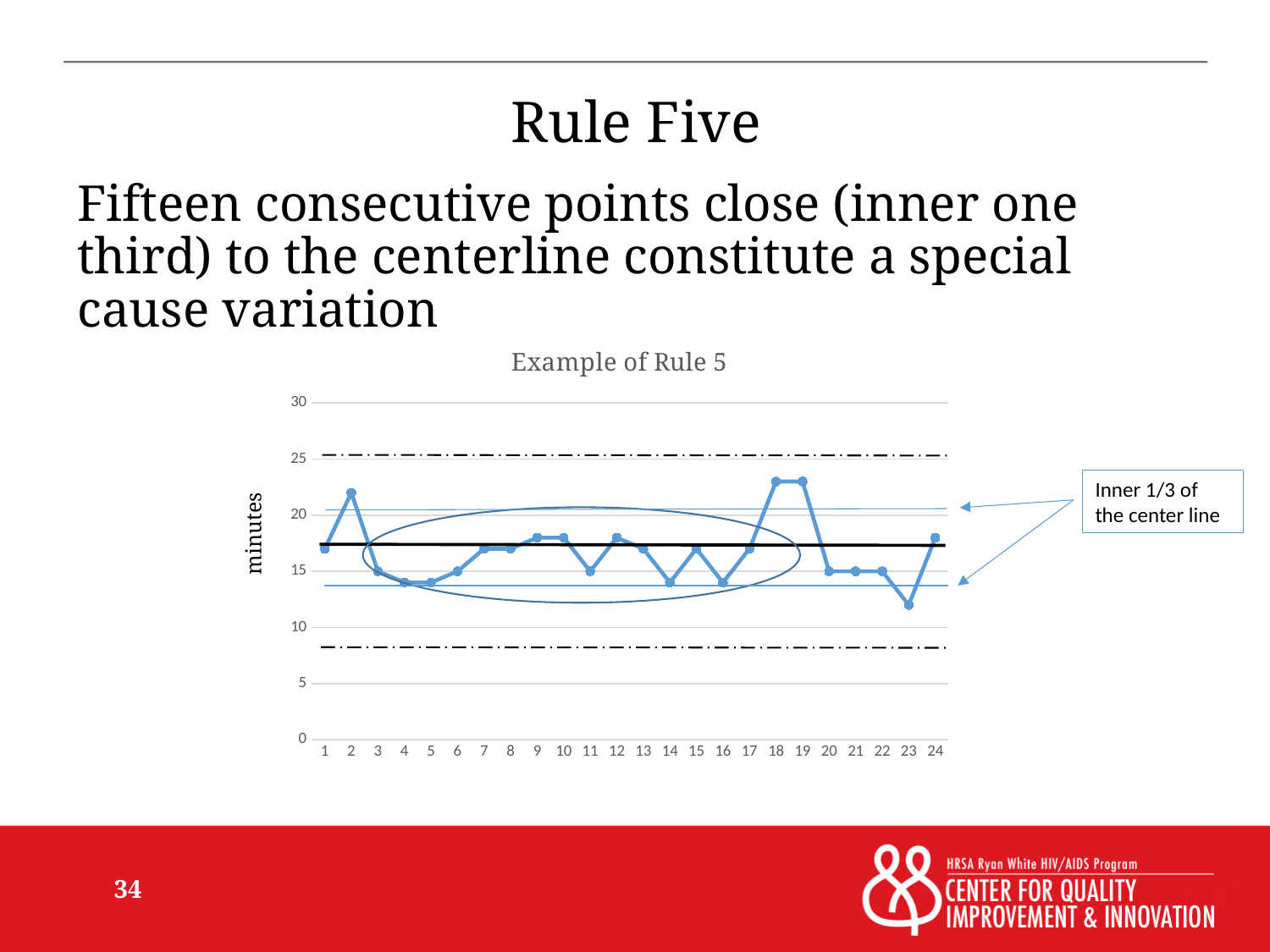
Is the value at point 4 greater or less than 15? less How many data points are plotted on the x axis of the chart? 24 Is the value at point 23 greater or less than 15? less Is the value at point 3 greater or less than 10? greater What kind of chart is shown on the slide? line chart What is the title of the chart? Example of Rule 5 Which is larger, the value at point 2 or the value at point 3? point 2 Which point has the lowest value on the chart? 23 What is the label on the vertical axis of the chart? minutes